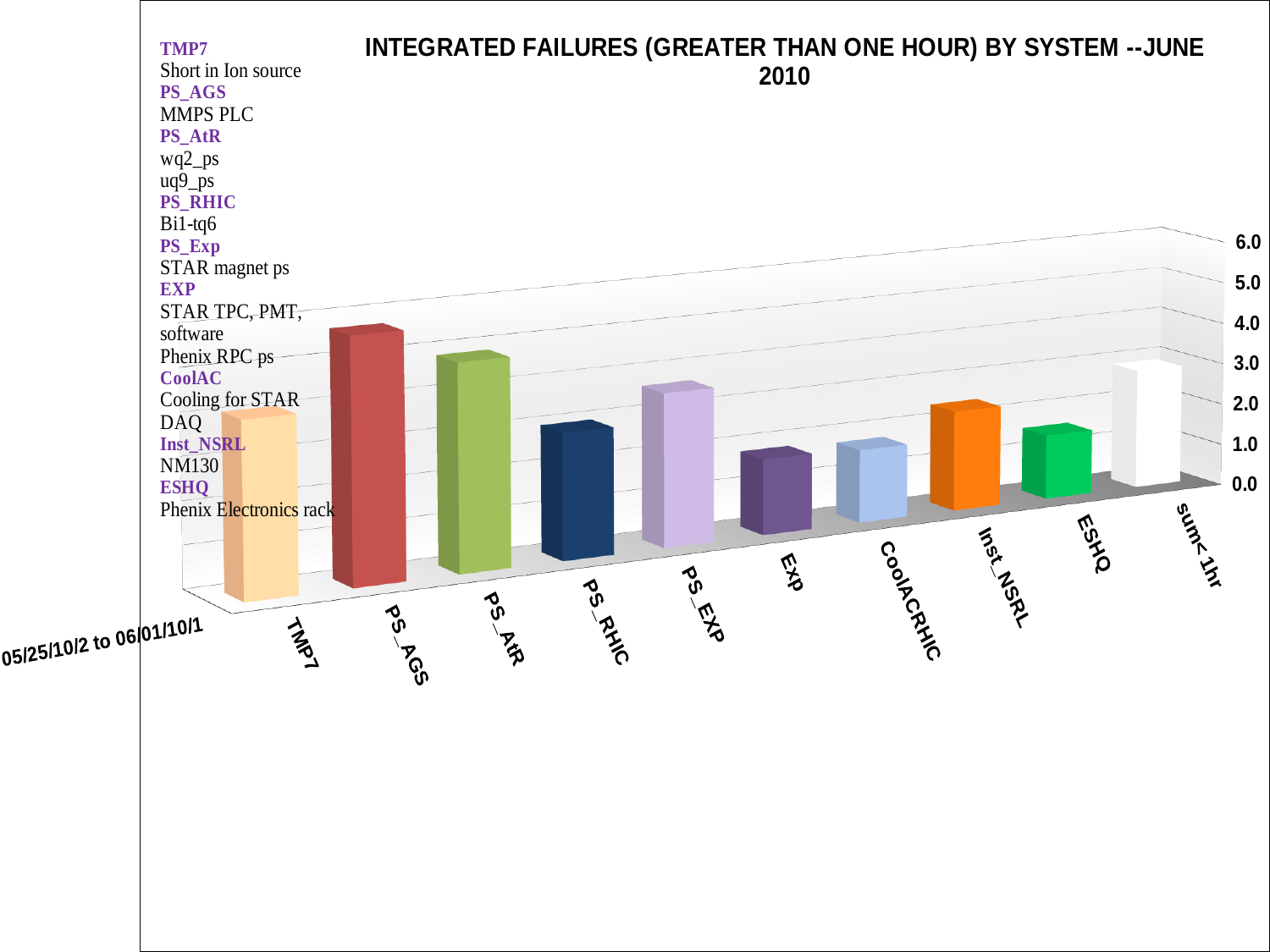
Which is larger, the value for PS_AtR or the value for Exp? PS_AtR How many system categories are plotted along the x axis of the chart? 10 What is the highest value shown on the chart's vertical axis? 6.0 Is the value for CoolACRHIC greater or less than 4.0? less Which system has the highest bar in the chart? PS_AGS Which is larger, the value for PS_AGS or the value for Exp? PS_AGS What is the title of the chart? INTEGRATED FAILURES (GREATER THAN ONE HOUR) BY SYSTEM --JUNE 2010 Is the value for Exp greater or less than 3.0? less What kind of chart is shown on the slide? bar chart Which is larger, the value for PS_AGS or the value for PS_AtR? PS_AGS Is the value for PS_AGS greater or less than 3.0? greater